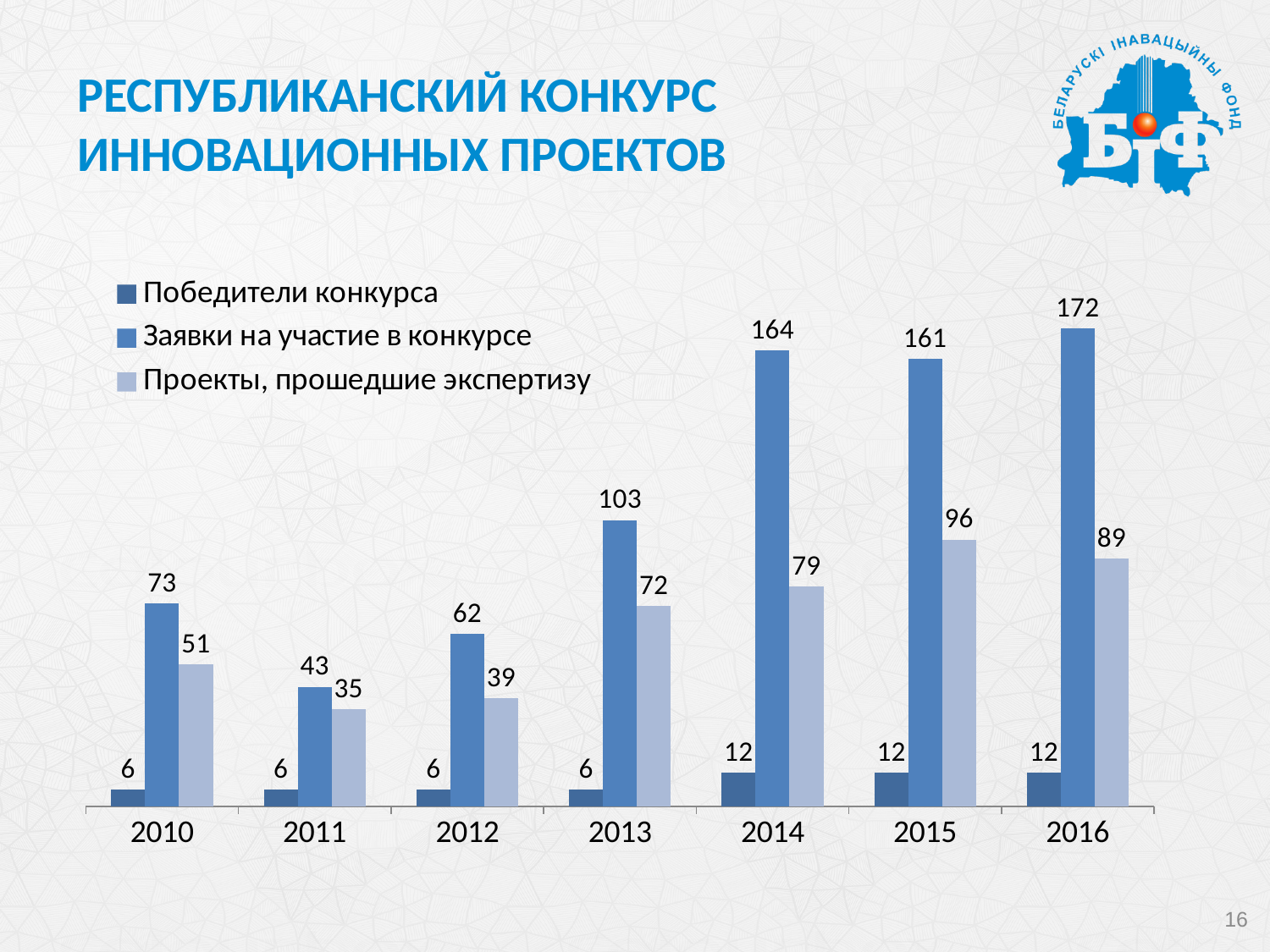
Which is larger: 'Проекты, прошедшие экспертизу' in 2015 or in 2016? 2015 What is the value of 'Проекты, прошедшие экспертизу' for 2012? 39 Which series is shown in the lightest blue colour? Проекты, прошедшие экспертизу What is the value of 'Заявки на участие в конкурсе' for 2014? 164 How many years are shown on the x axis? 7 What is the difference between 'Заявки на участие в конкурсе' and 'Проекты, прошедшие экспертизу' in 2013? 31 What is the value of 'Победители конкурса' for 2016? 12 In which year is 'Проекты, прошедшие экспертизу' lowest? 2011 What type of chart is shown on the slide? bar chart Does 'Заявки на участие в конкурсе' generally rise or fall from 2011 to 2016? rise How many series does the legend list? 3 In which year is 'Заявки на участие в конкурсе' highest? 2016